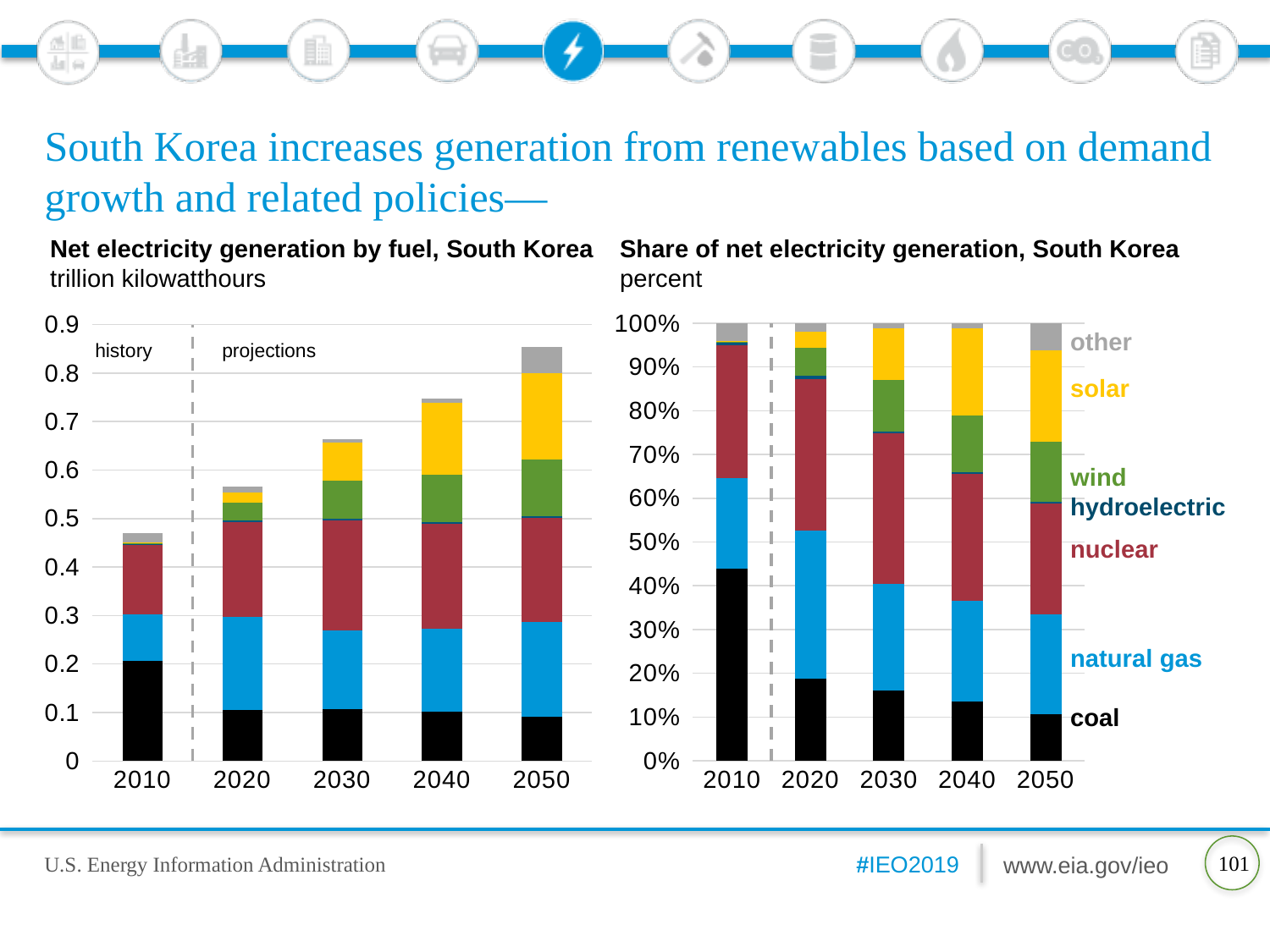
In the 'Net electricity generation by fuel, South Korea' chart, is the total bar for 2050 greater or less than 0.8 trillion kilowatthours? greater In the 'Share of net electricity generation, South Korea' chart, is the coal share in 2030 greater or less than 20%? less In the 'Net electricity generation by fuel, South Korea' chart, is the total bar for 2010 greater or less than 0.5 trillion kilowatthours? less What kind of chart is the 'Net electricity generation by fuel, South Korea' chart? stacked bar chart How many fuel series does the legend of the 'Share of net electricity generation, South Korea' chart list? 7 In the 'Net electricity generation by fuel, South Korea' chart, do total generation values rise or fall from 2010 to 2050? rise How many years are shown on the x axis of the 'Net electricity generation by fuel, South Korea' chart? 5 In the 'Share of net electricity generation, South Korea' chart, which year has the highest coal share? 2010 In the 'Net electricity generation by fuel, South Korea' chart, which year has the highest total net electricity generation? 2050 In the 'Net electricity generation by fuel, South Korea' chart, which year has the lowest total net electricity generation? 2010 What unit is used on the 'Net electricity generation by fuel, South Korea' chart? trillion kilowatthours